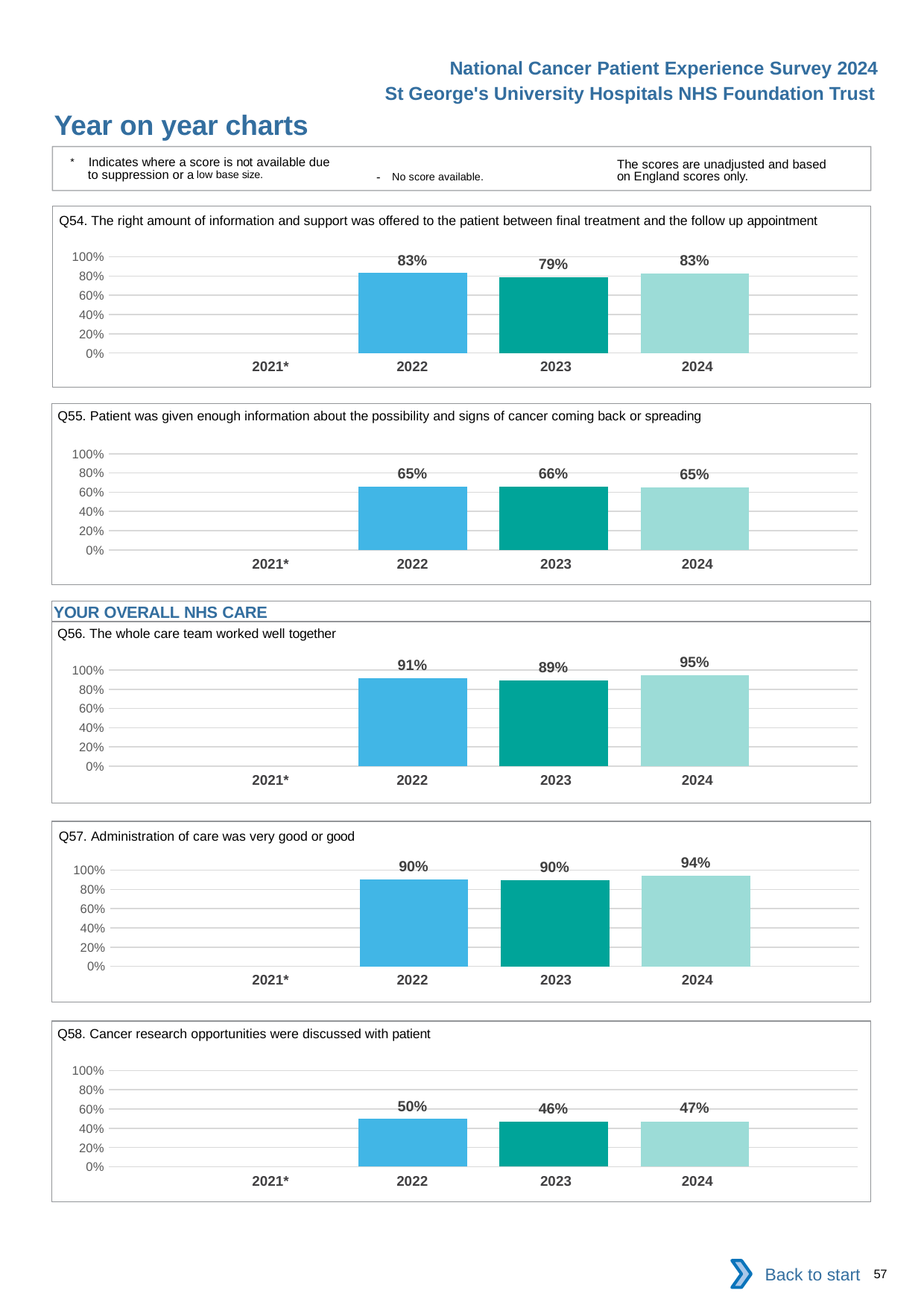
In the Q56 chart, what is the difference between the 2024 and 2023 values? 6% In the Q55 chart, what is the difference between the 2023 and 2024 values? 1% Which year on the x axis of each chart is marked with an asterisk? 2021* In the Q57 chart, what is the value for 2024? 94% In the Q54 chart, how many years have a bar plotted? 3 In the Q55 chart, which year has the highest value? 2023 In the Q56 chart, what is the value for 2022? 91% In the Q54 chart, what is the value for 2023? 79% What kind of chart is the Q57 chart? bar chart In the Q58 chart, is the value for 2022 larger or smaller than the value for 2024? larger In the Q58 chart, which year has the lowest value? 2023 In the Q58 chart, is the value for 2022 greater or less than 40%? greater